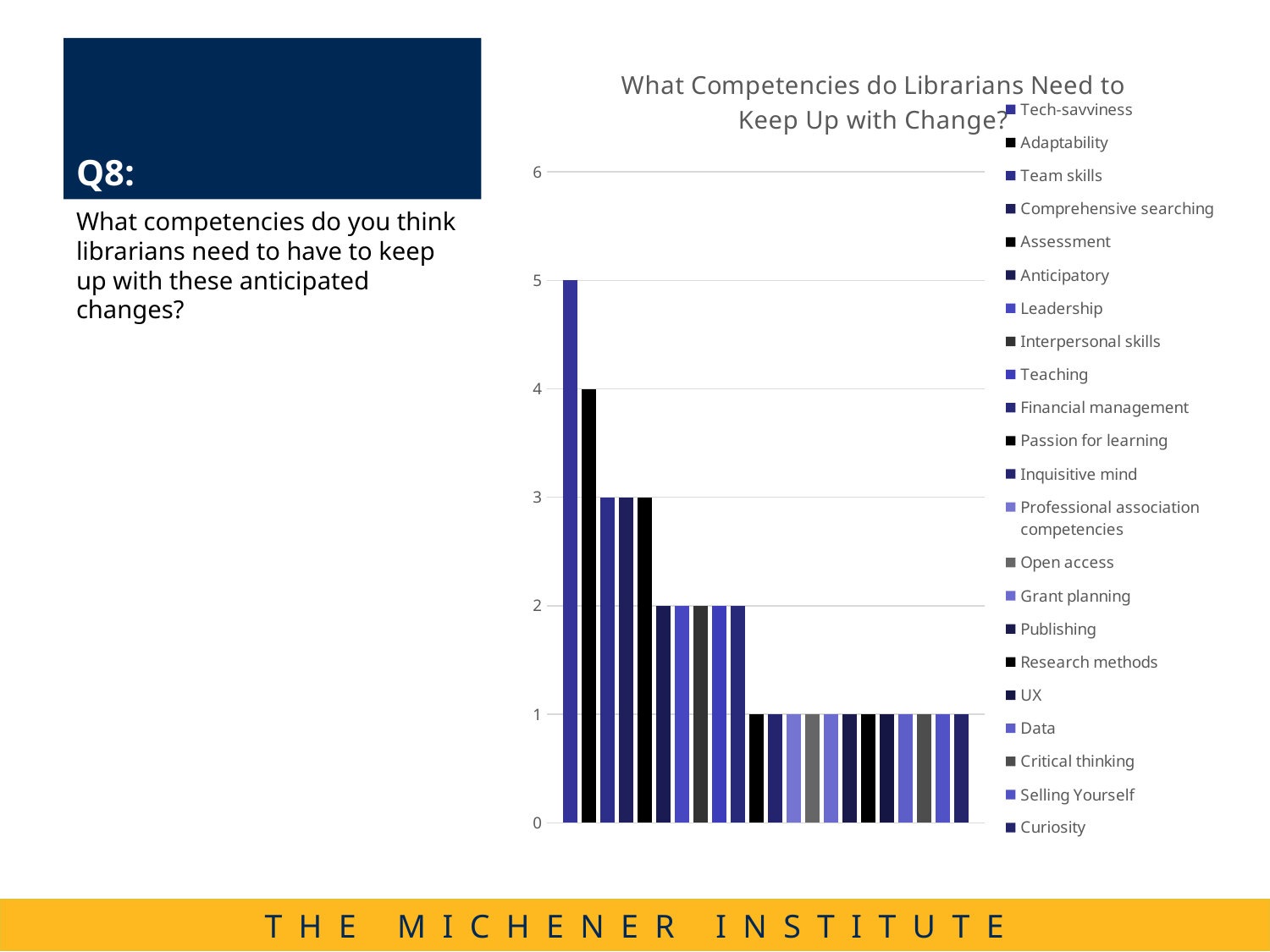
What is the title of the chart? What Competencies do Librarians Need to Keep Up with Change? What is the value for Adaptability? 4 What is the value for Tech-savviness? 5 How many bars are plotted in the chart? 22 How many entries does the legend list? 22 Which is larger, the value for Tech-savviness or the value for Adaptability? Tech-savviness How many bars in the chart have a value of 1? 12 What kind of chart is shown on the slide? bar chart Do the bar values rise or fall from left to right across the chart? fall Is the value for Tech-savviness greater or less than 4? greater What is the difference between the values for Tech-savviness and Adaptability? 1 Which competency has the highest value in the chart? Tech-savviness